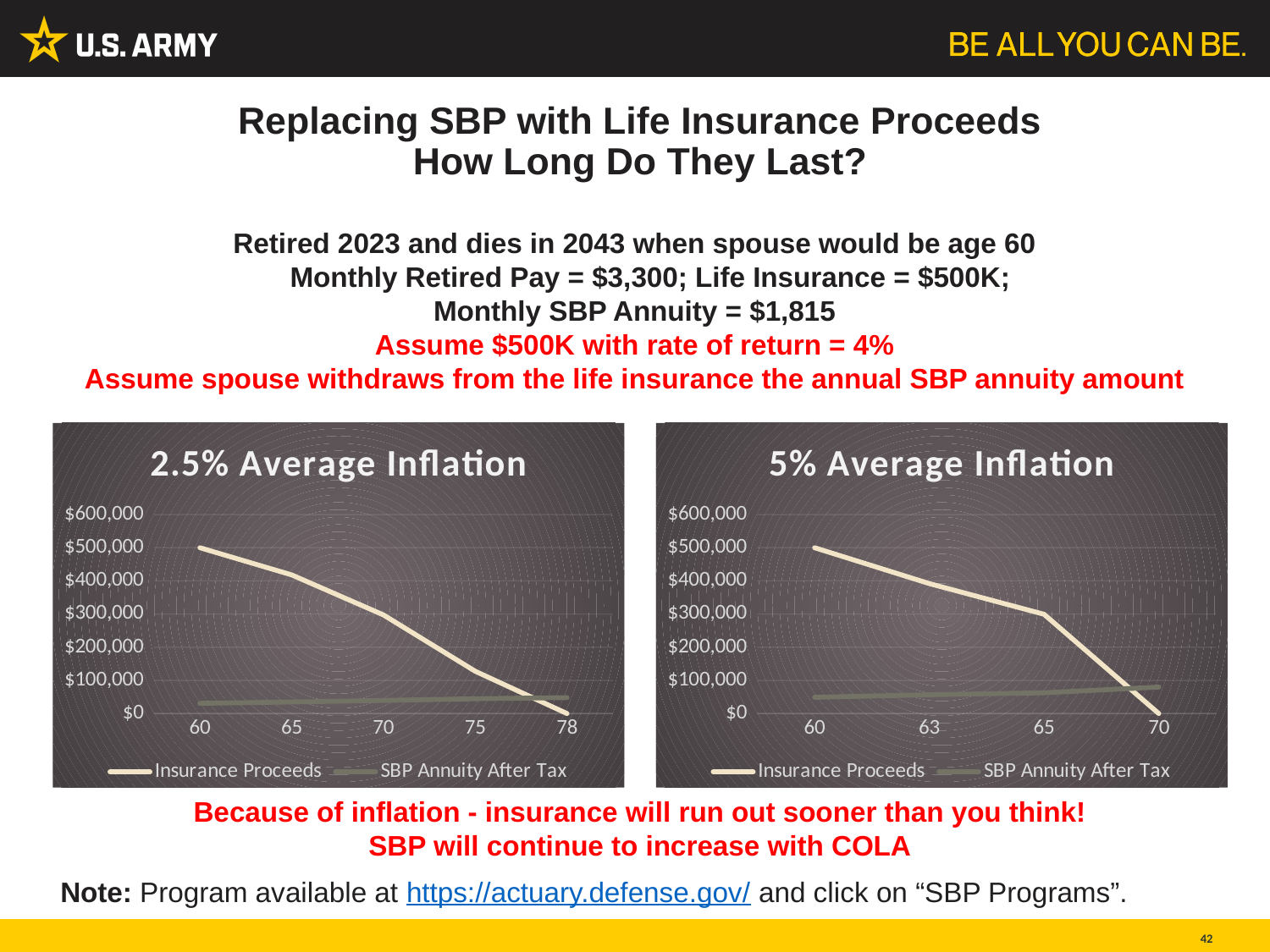
In the "2.5% Average Inflation" chart, how many age points are labelled on the x axis? 5 In the "5% Average Inflation" chart, how many age points are labelled on the x axis? 4 In the "2.5% Average Inflation" chart, is the Insurance Proceeds value at age 75 greater or less than $200,000? less In the "2.5% Average Inflation" chart, is the Insurance Proceeds value at age 70 greater or less than $400,000? less In the "5% Average Inflation" chart, is the Insurance Proceeds value at age 63 greater or less than $300,000? greater How many series does the legend of the "5% Average Inflation" chart list? 2 In the "2.5% Average Inflation" chart, does the Insurance Proceeds line rise or fall as age increases? fall What kind of chart is the "2.5% Average Inflation" chart? line chart What is the title of the chart on the right side of the slide? 5% Average Inflation In the "5% Average Inflation" chart, which series is higher at age 60, Insurance Proceeds or SBP Annuity After Tax? Insurance Proceeds What is the last age labelled on the x axis of the "2.5% Average Inflation" chart? 78 In the "5% Average Inflation" chart, does the SBP Annuity After Tax line rise or fall as age increases? rise